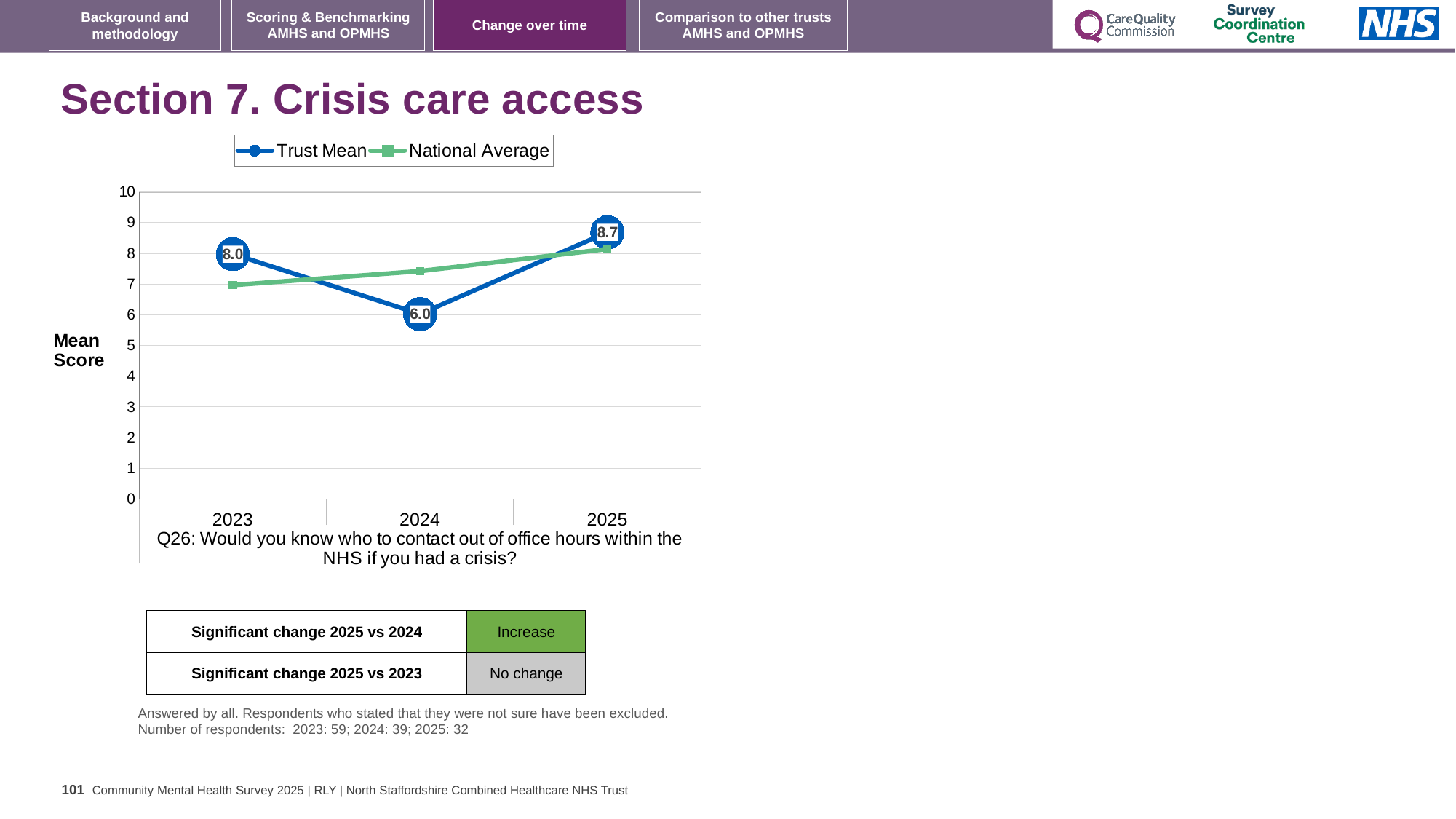
Which is larger in 2024, the Trust Mean or the National Average? National Average In which year is the Trust Mean highest? 2025 By how much did the Trust Mean increase from 2024 to 2025? 2.7 How many years are plotted on the x axis? 3 Is the National Average for 2023 greater or less than 8? less What kind of chart is shown on the slide? line chart Is the National Average for 2025 greater or less than 7? greater In which year is the Trust Mean lowest? 2024 How many series does the legend list? 2 What is the Trust Mean score for 2023? 8.0 What is the Trust Mean score for 2025? 8.7 What is the Trust Mean score for 2024? 6.0